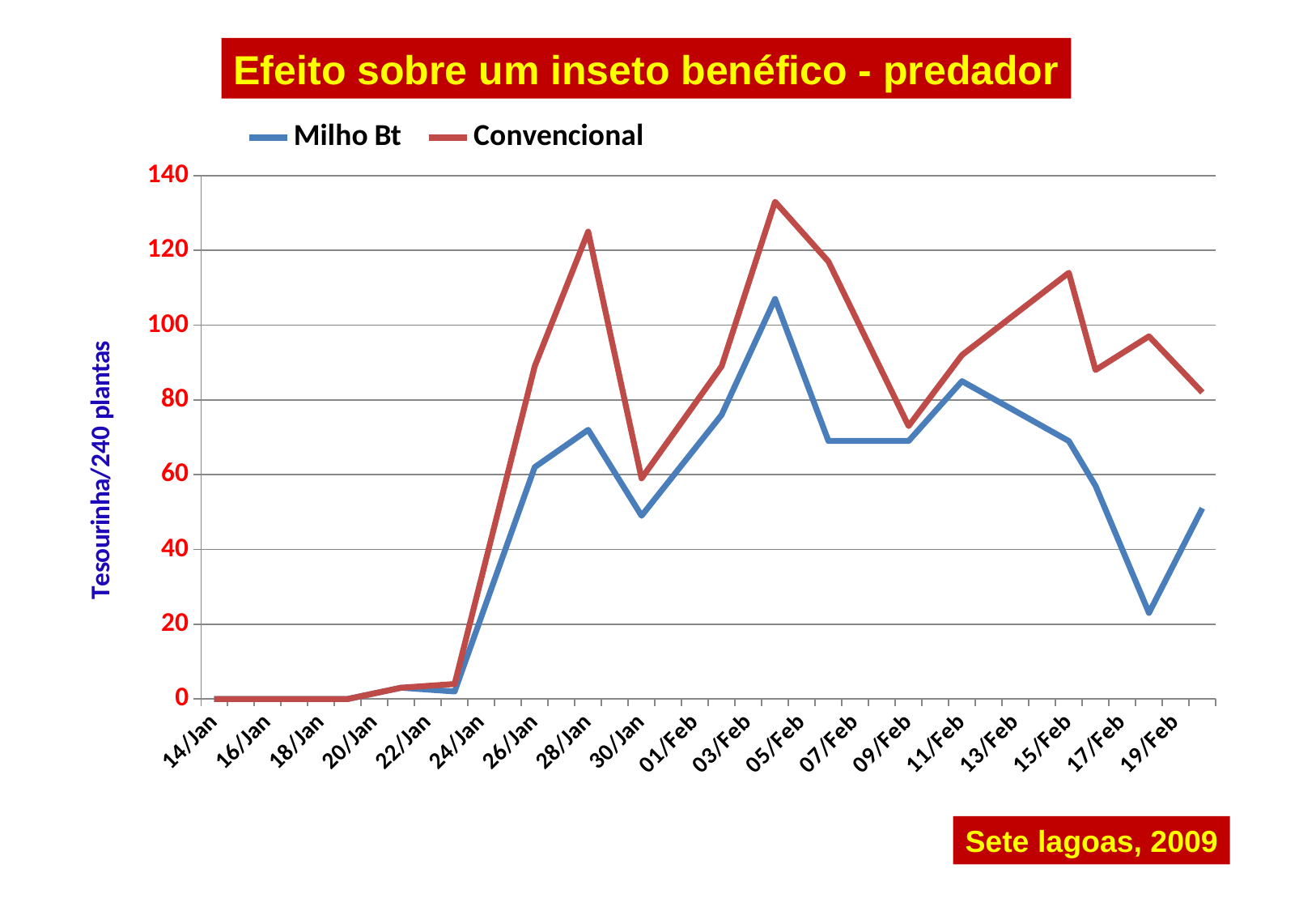
Is the value for Milho Bt on 05/Feb greater or less than 100? greater What kind of chart is shown on the slide? line chart How many series does the legend list? 2 Is the value for Milho Bt on 30/Jan greater or less than 60? less Is the value for Convencional on 05/Feb greater or less than 120? greater On which date does the Convencional series reach its highest value? 05/Feb What is the label on the vertical axis? Tesourinha/240 plantas Does the Milho Bt series rise or fall between 15/Feb and 19/Feb? fall What is the title of the chart? Efeito sobre um inseto benéfico - predador On 05/Feb, which series has the higher value, Milho Bt or Convencional? Convencional